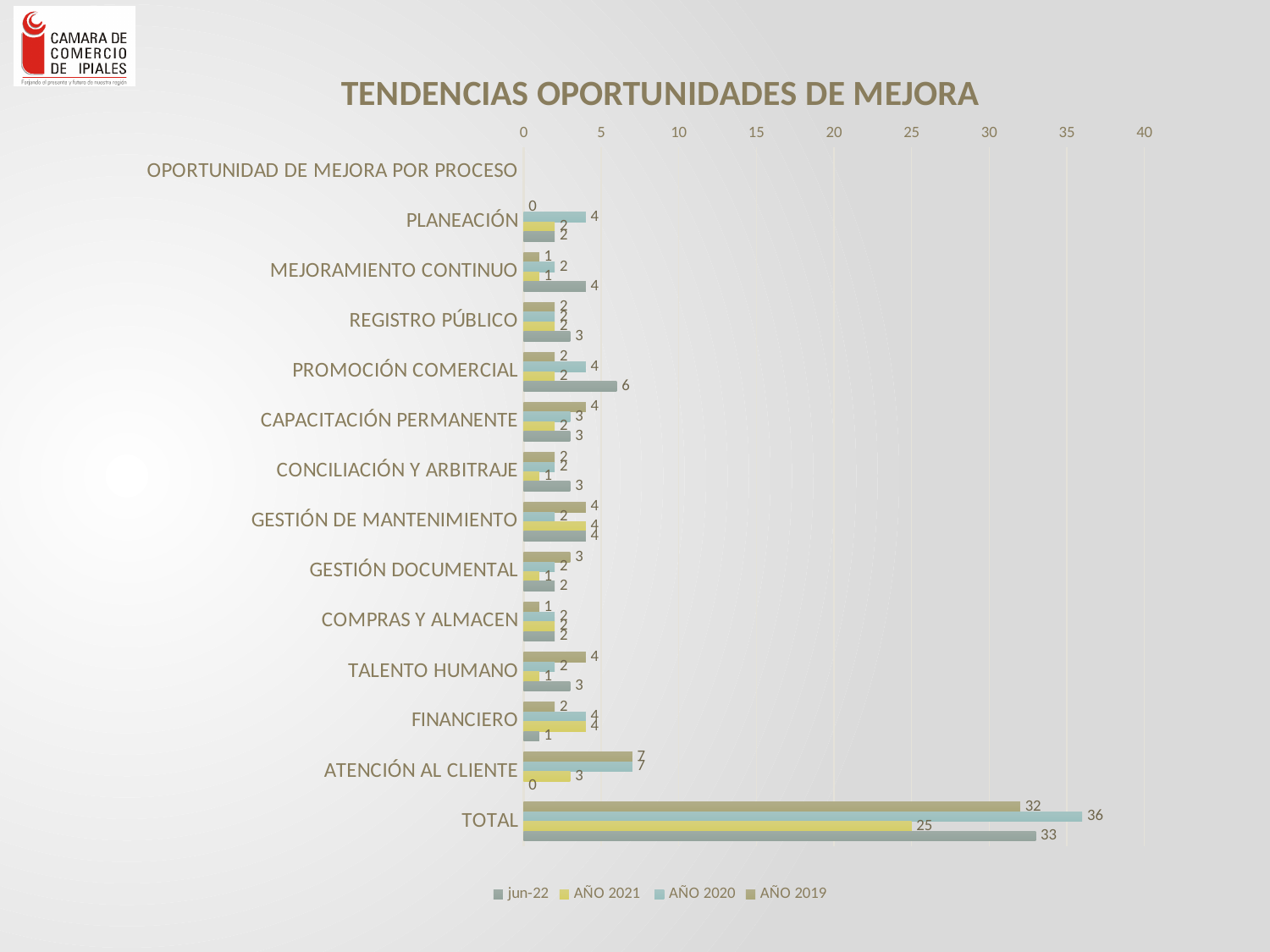
Is the TOTAL value for AÑO 2021 greater or less than 30? less What is the TOTAL value for jun-22? 33 What is the TOTAL value for AÑO 2020? 36 How many series does the legend list? 4 What is the jun-22 value for PROMOCIÓN COMERCIAL? 6 What is the difference between the TOTAL values for AÑO 2020 and AÑO 2021? 11 Which series has the highest TOTAL value? AÑO 2020 What is the TOTAL value for AÑO 2019? 32 Which series has the lowest TOTAL value? AÑO 2021 What kind of chart is shown on the slide? Bar chart What is the TOTAL value for AÑO 2021? 25 What is the title of the chart? TENDENCIAS OPORTUNIDADES DE MEJORA